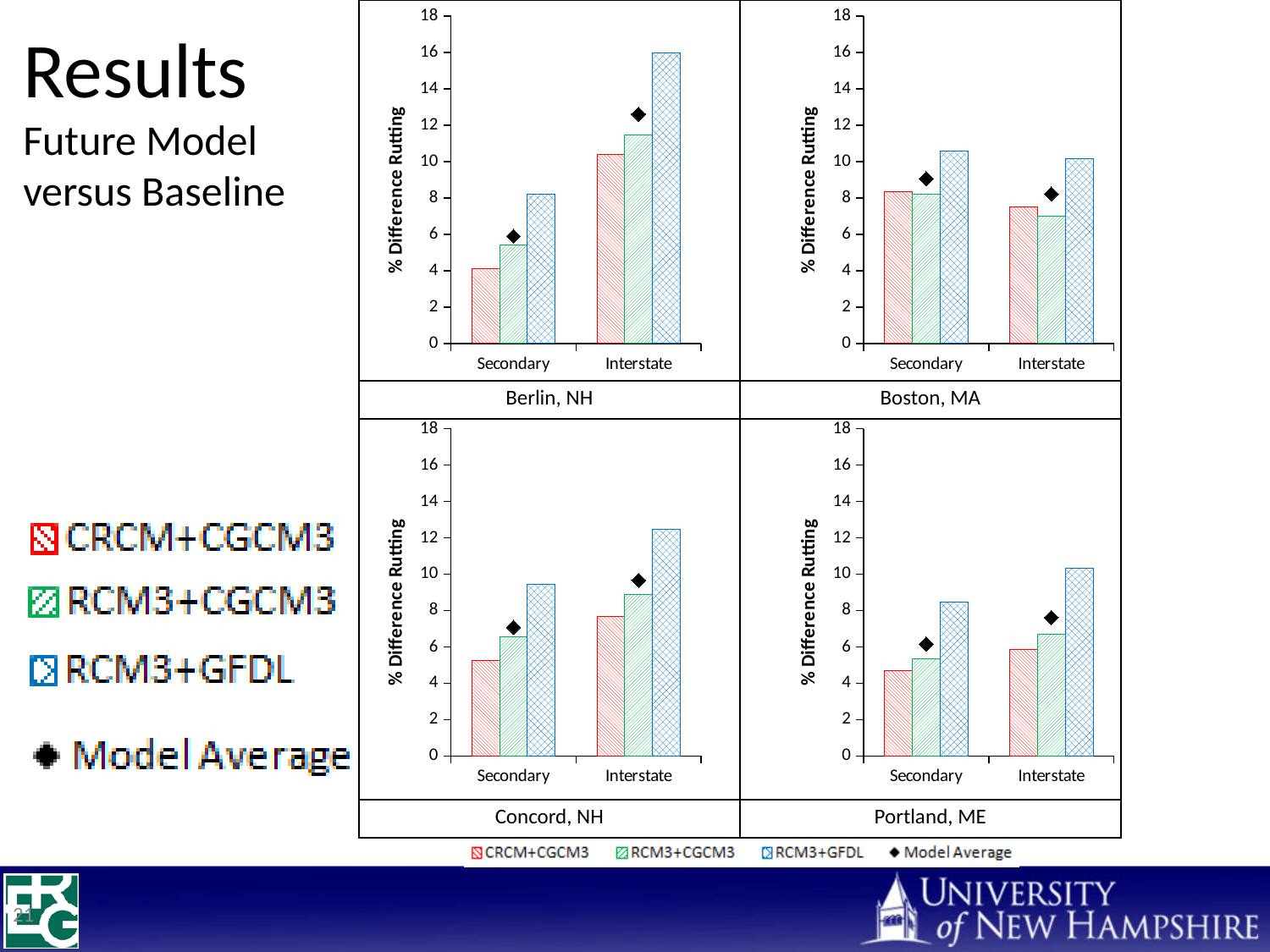
In the Berlin, NH chart, do the RCM3+GFDL values rise or fall from Secondary to Interstate? rise In the Portland, ME chart, is the RCM3+GFDL value for Interstate greater or less than 8? greater In the Berlin, NH chart, which bar is the highest? RCM3+GFDL for Interstate In the Berlin, NH chart, is the CRCM+CGCM3 value for Secondary greater or less than 6? less What kind of chart is used for Berlin, NH? bar chart How many series does the legend at the bottom of the slide list? 4 How many road categories are shown on the x axis of the Concord, NH chart? 2 In the Concord, NH chart, is the CRCM+CGCM3 value for Secondary greater or less than 6? less In the Boston, MA chart, is the CRCM+CGCM3 value larger for Secondary or for Interstate? Secondary What is the label on the y axis of the Portland, ME chart? % Difference Rutting